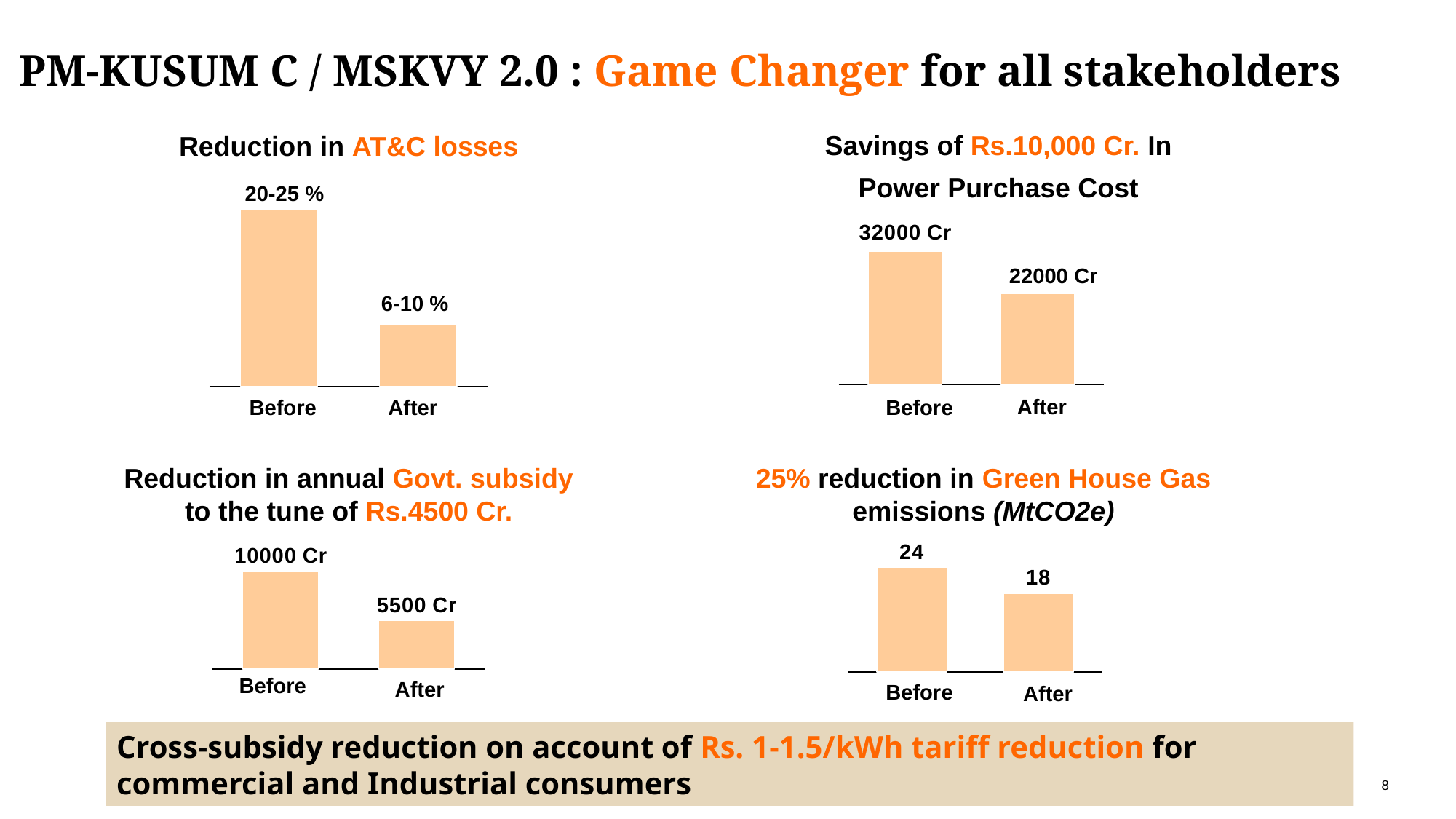
How many categories are shown in the 'Reduction in annual Govt. subsidy' chart? 2 In the 'Reduction in annual Govt. subsidy' chart, what is the difference between the Before and After values? 4500 Cr In the '25% reduction in Green House Gas emissions (MtCO2e)' chart, what is the value for After? 18 In the 'Savings of Rs.10,000 Cr. In Power Purchase Cost' chart, which is larger, Before or After? Before In the '25% reduction in Green House Gas emissions (MtCO2e)' chart, which category has the lower value? After In the 'Savings of Rs.10,000 Cr. In Power Purchase Cost' chart, what is the difference between the Before and After values? 10000 Cr In the 'Reduction in AT&C losses' chart, what is the value for Before? 20-25 % In the 'Reduction in AT&C losses' chart, what is the value for After? 6-10 % In the 'Reduction in annual Govt. subsidy' chart, what is the value for After? 5500 Cr What type of chart is the 'Reduction in AT&C losses' chart? Bar chart In the 'Savings of Rs.10,000 Cr. In Power Purchase Cost' chart, what is the value for Before? 32000 Cr In the '25% reduction in Green House Gas emissions (MtCO2e)' chart, what is the value for Before? 24